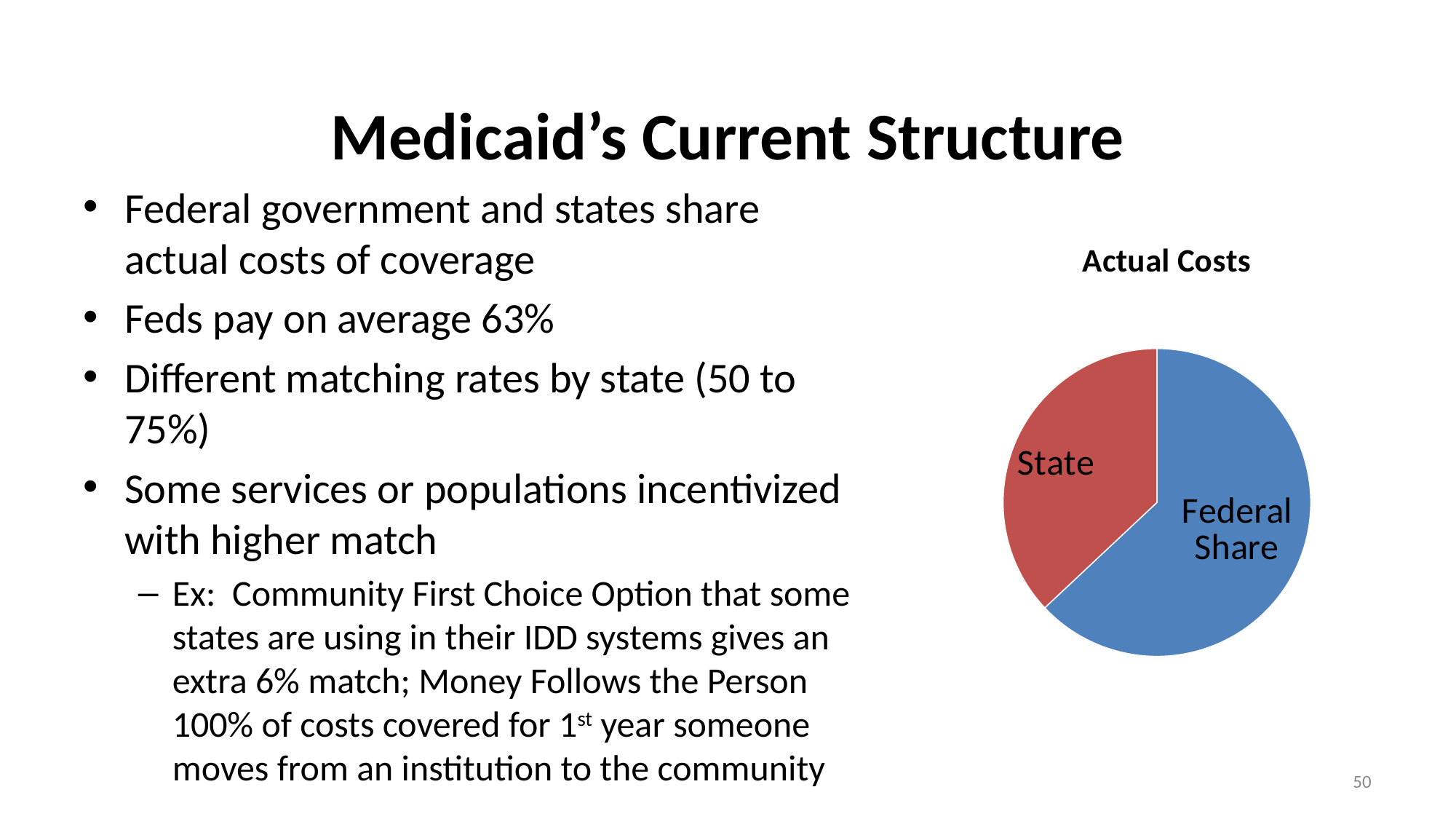
How many slices does the Actual Costs pie chart have? 2 Which slice of the Actual Costs pie chart is the largest? Federal Share In the Actual Costs pie chart, which is larger, the Federal Share slice or the State slice? Federal Share What is the title of the pie chart? Actual Costs Does the Federal Share slice take up more or less than half of the Actual Costs pie chart? more What kind of chart is shown on the slide? pie chart What colour is the Federal Share slice in the Actual Costs pie chart? blue Which slice of the Actual Costs pie chart is the smallest? State